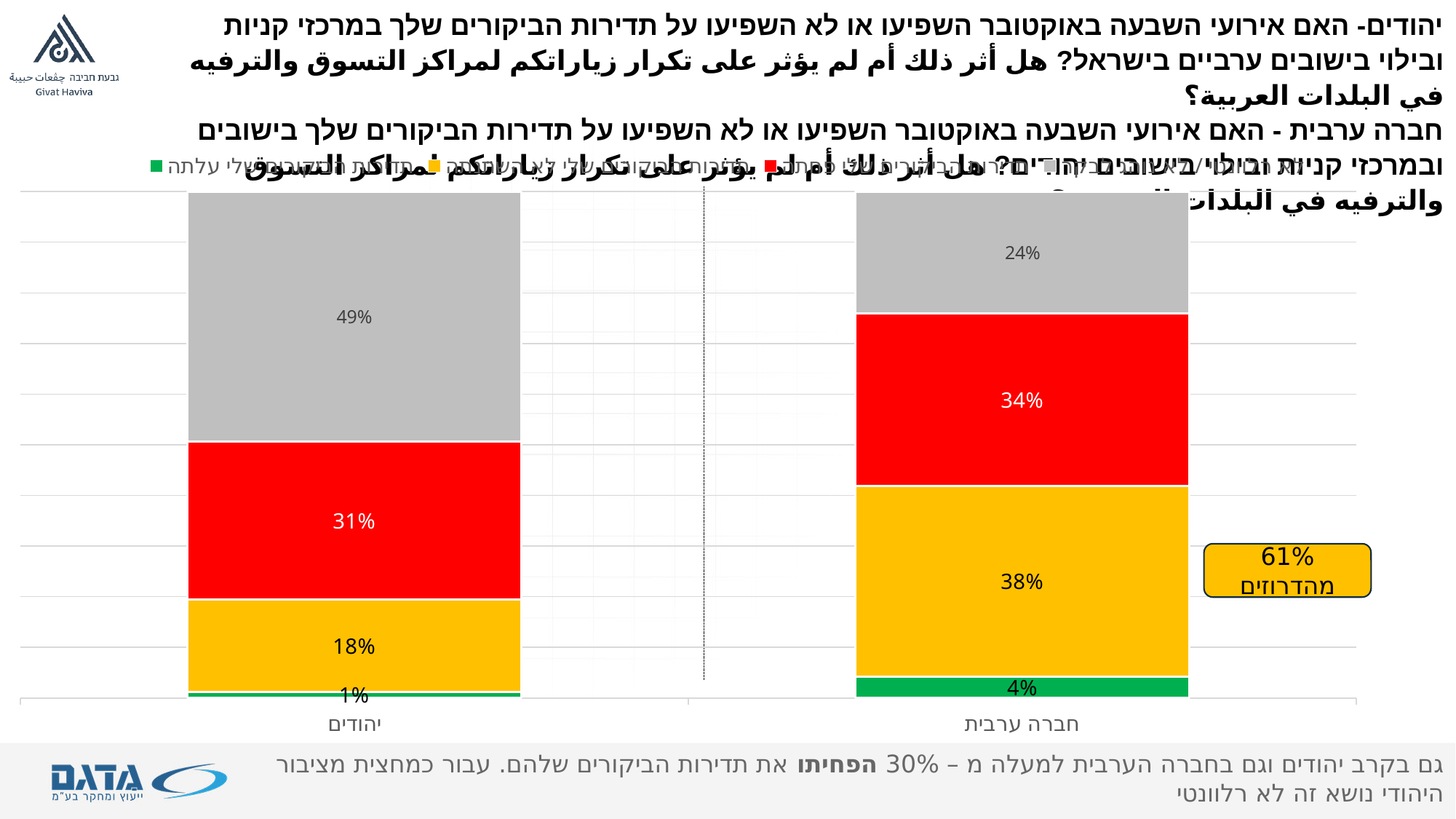
Which category has the larger gray segment, יהודים or חברה ערבית? יהודים What is the value of the yellow segment for יהודים? 18% What is the value of the gray segment for חברה ערבית? 24% Which category has the larger red segment, יהודים or חברה ערבית? חברה ערבית What is the difference between the yellow segment values for חברה ערבית and יהודים? 20 percentage points What is the total of the stacked bar for חברה ערבית? 100% How many categories are shown on the x axis? 2 What is the value of the gray segment for יהודים? 49% What is the value of the green segment for חברה ערבית? 4% What kind of chart is shown on the slide? Stacked bar chart Which segment is the smallest in the יהודים bar? The green segment (1%) What is the value of the red segment for חברה ערבית? 34%